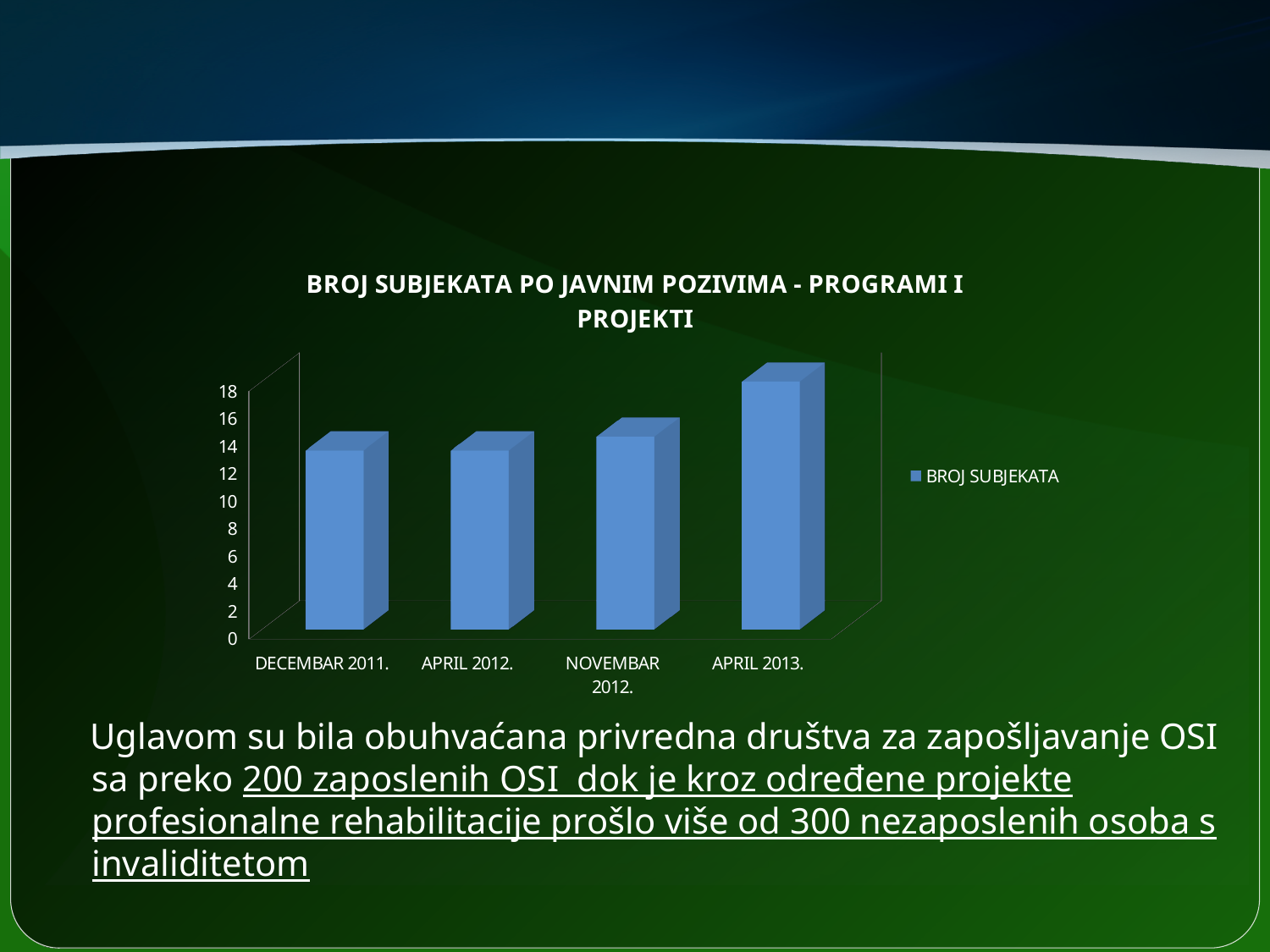
Is the value for NOVEMBAR 2012. greater or less than 10? greater Which category has the highest value in the chart? APRIL 2013. Is the value for DECEMBAR 2011. greater or less than 16? less How many categories are shown on the x axis of the chart? 4 What series name is shown in the chart legend? BROJ SUBJEKATA What kind of chart is shown on the slide? bar chart Is the value for APRIL 2013. greater or less than 16? greater How many series does the chart legend list? 1 Do the values generally rise or fall from DECEMBAR 2011. to APRIL 2013.? rise Which is larger, the value for APRIL 2013. or the value for NOVEMBAR 2012.? APRIL 2013. What is the title of the chart? BROJ SUBJEKATA PO JAVNIM POZIVIMA - PROGRAMI I PROJEKTI